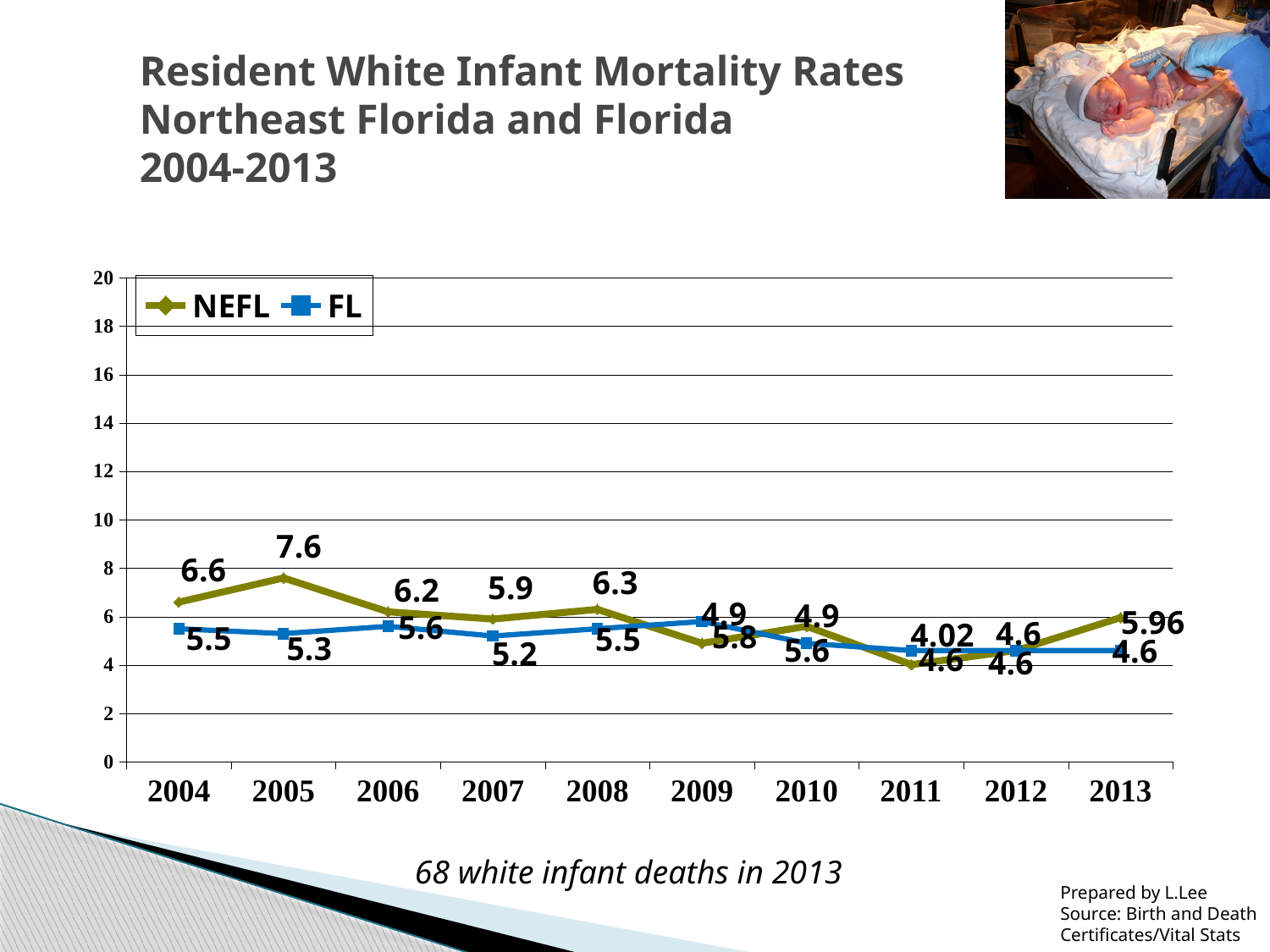
In 2005, which series has the higher rate, NEFL or FL? NEFL What is the NEFL rate in 2013? 5.96 What is the FL white infant mortality rate in 2004? 5.5 What is the difference between the NEFL and FL rates in 2013? 1.36 In which year is the NEFL rate lowest? 2011 What type of chart is shown on the slide? Line chart In which year is the NEFL rate highest? 2005 How many series does the legend list? 2 How many years are plotted along the x axis? 10 What is the NEFL white infant mortality rate in 2005? 7.6 What is the NEFL rate in 2011? 4.02 Is the NEFL rate in 2005 greater or less than 10? less